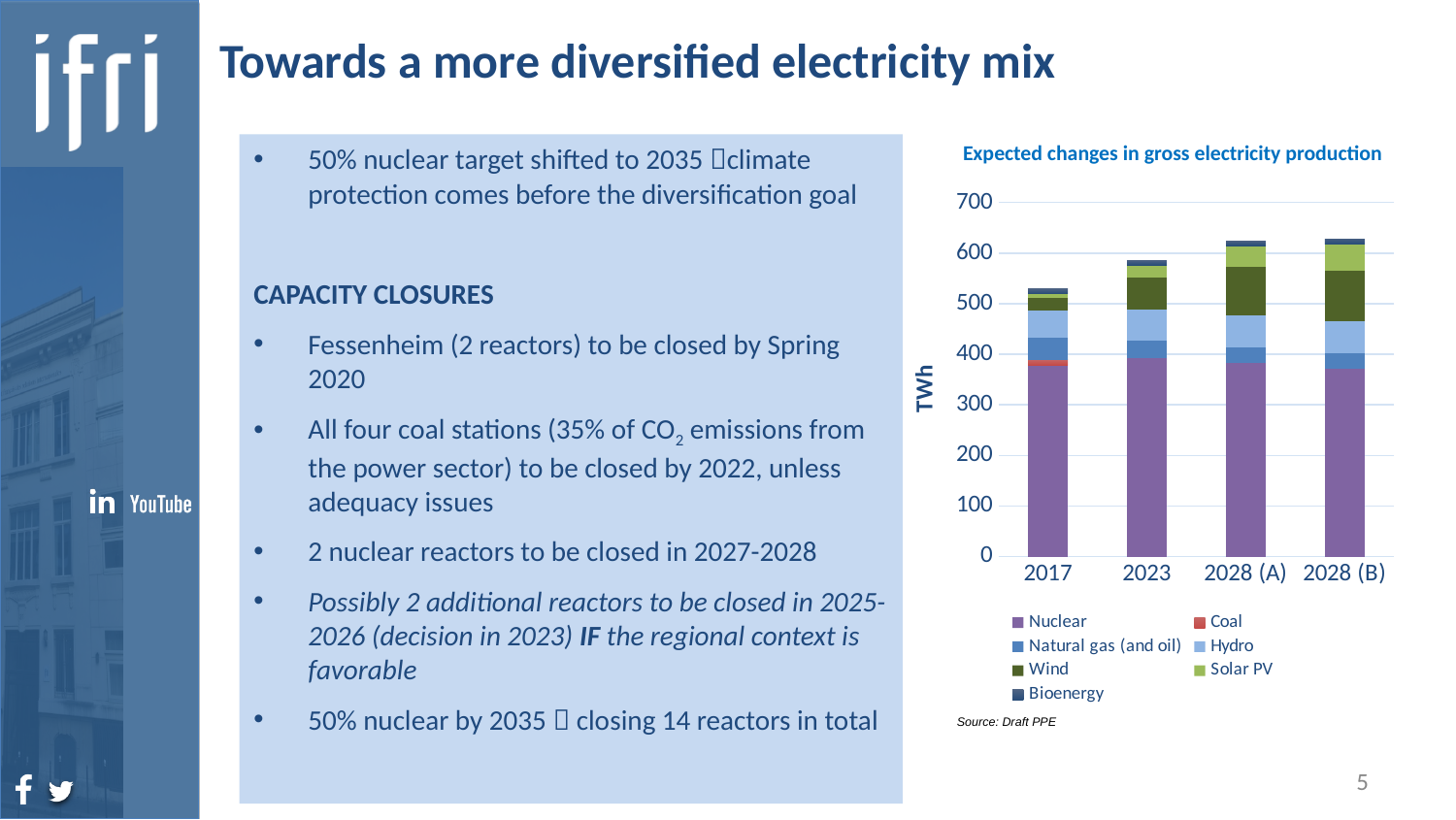
How many series does the chart legend list? 7 What is the title of the chart? Expected changes in gross electricity production Do the total bar heights rise or fall from 2017 to 2028 (B)? rise How many categories (bars) are shown along the x axis? 4 Which category has the lowest total gross electricity production? 2017 Is the Nuclear value for 2017 greater or less than 400 TWh? less Is the total bar height for 2023 greater or less than 600 TWh? less What unit is shown on the vertical axis of the chart? TWh What kind of chart is shown on the slide? stacked bar chart Is the total bar height for 2017 greater or less than 500 TWh? greater Which has the larger total gross electricity production, 2017 or 2023? 2023